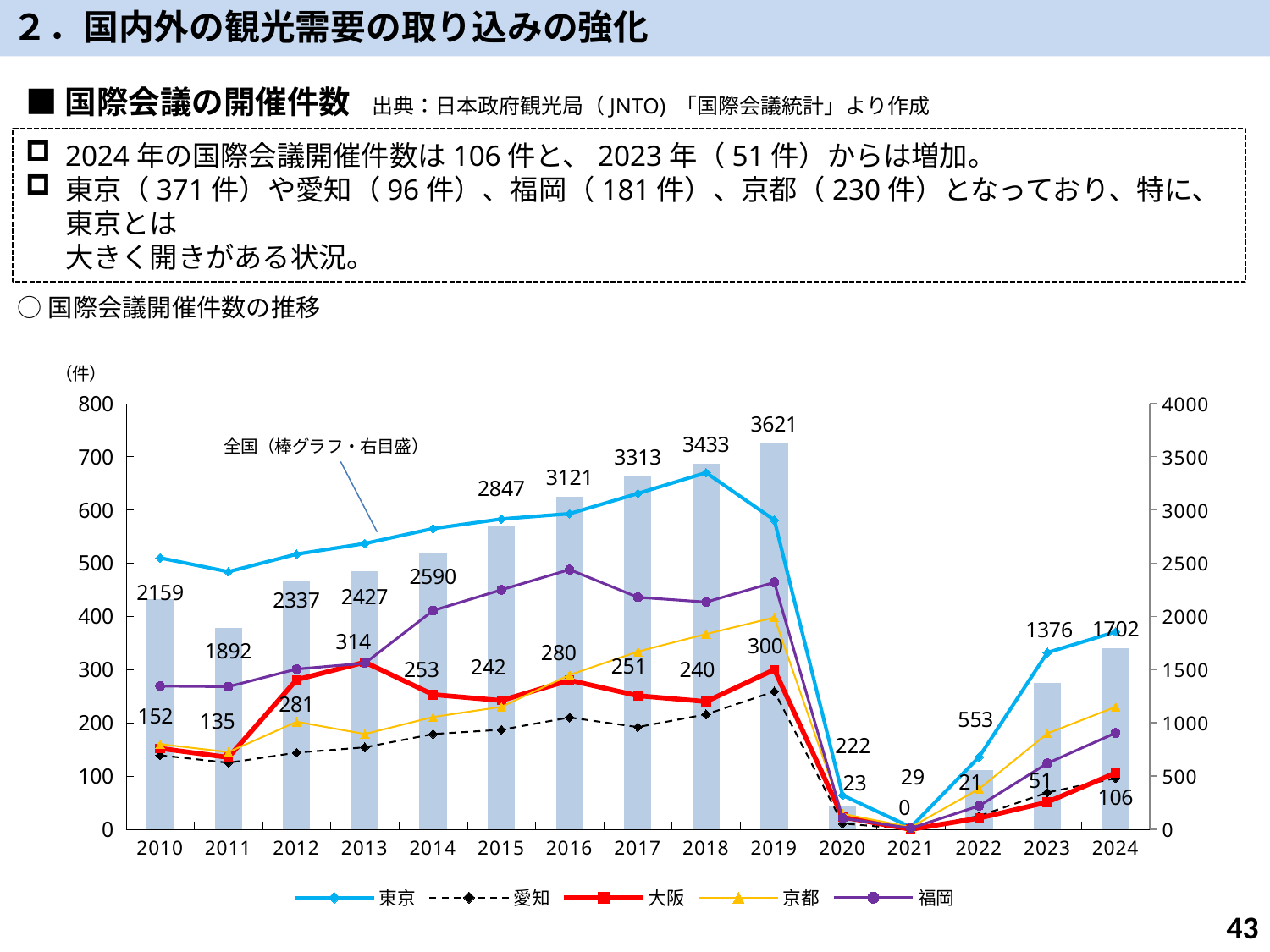
What kind of chart is this? Combined bar and line chart In which year is the 全国 bar lowest? 2021 How many years are shown on the x axis? 15 Which year has the larger 大阪 value, 2013 or 2016? 2013 What is the value of the 大阪 line for 2024? 106 In which year is the 全国 bar highest? 2019 How many series does the legend list? 5 What is the difference between the 大阪 values for 2019 and 2018? 60 By how much did the 全国 value increase from 2023 to 2024? 326 What is the value of the 全国 bar for 2019? 3621 What is the value of the 大阪 line for 2021? 0 Is the value for 東京 in 2019 greater or less than 500? greater